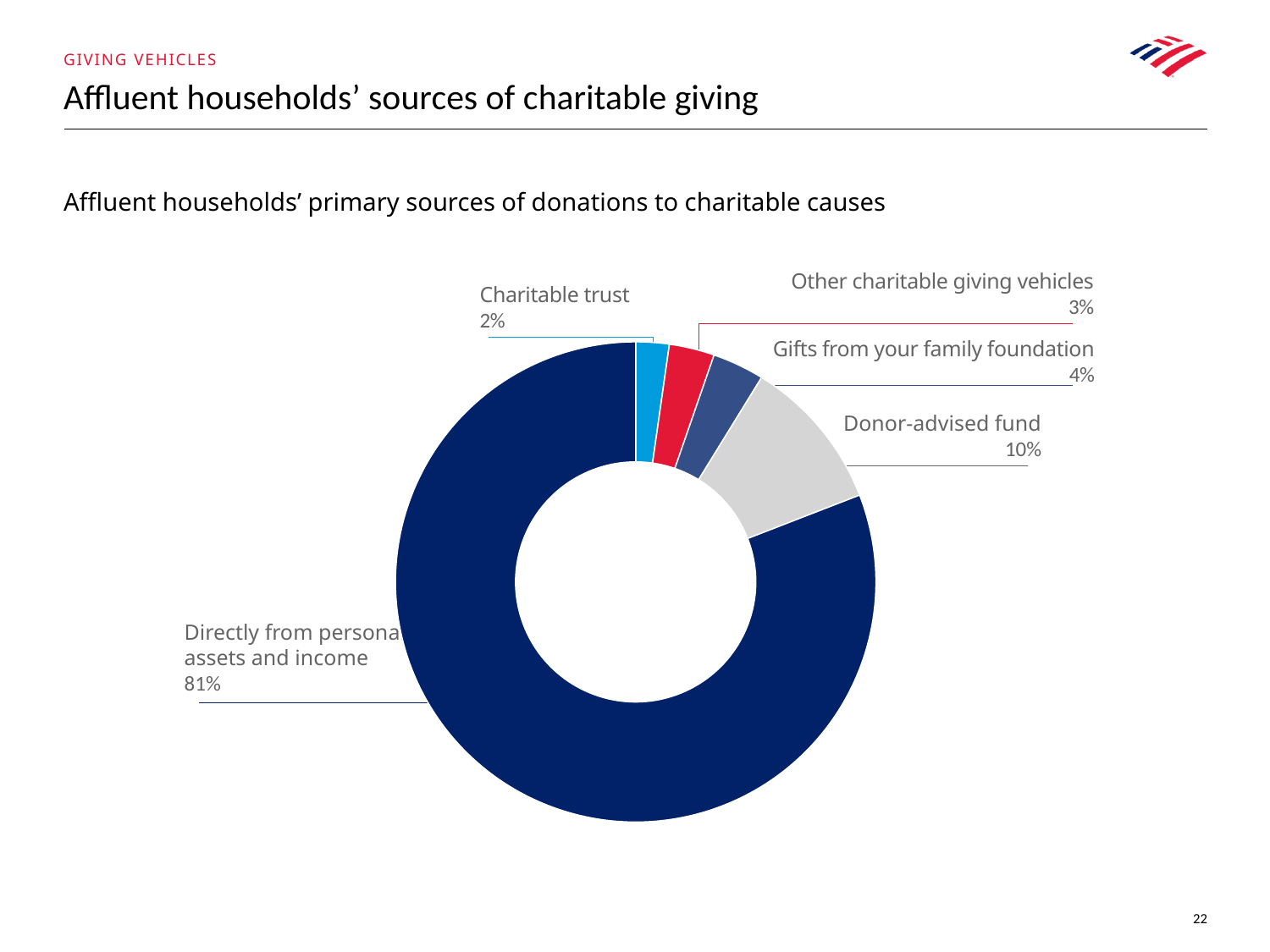
What percentage is shown for Charitable trust? 2% What percentage is shown for Other charitable giving vehicles? 3% Which is larger, the share for Other charitable giving vehicles or the share for Charitable trust? Other charitable giving vehicles What kind of chart is shown on the slide? Pie chart (donut) What share of affluent households' charitable giving comes directly from personal assets and income? 81% What percentage is shown for Donor-advised fund? 10% Which source of charitable giving has the smallest share? Charitable trust Which source of charitable giving has the largest share? Directly from personal assets and income How many categories are shown in the chart? 5 What is the title of the chart? Affluent households' primary sources of donations to charitable causes What is the difference in percentage points between Donor-advised fund and Gifts from your family foundation? 6 What percentage is shown for Gifts from your family foundation? 4%